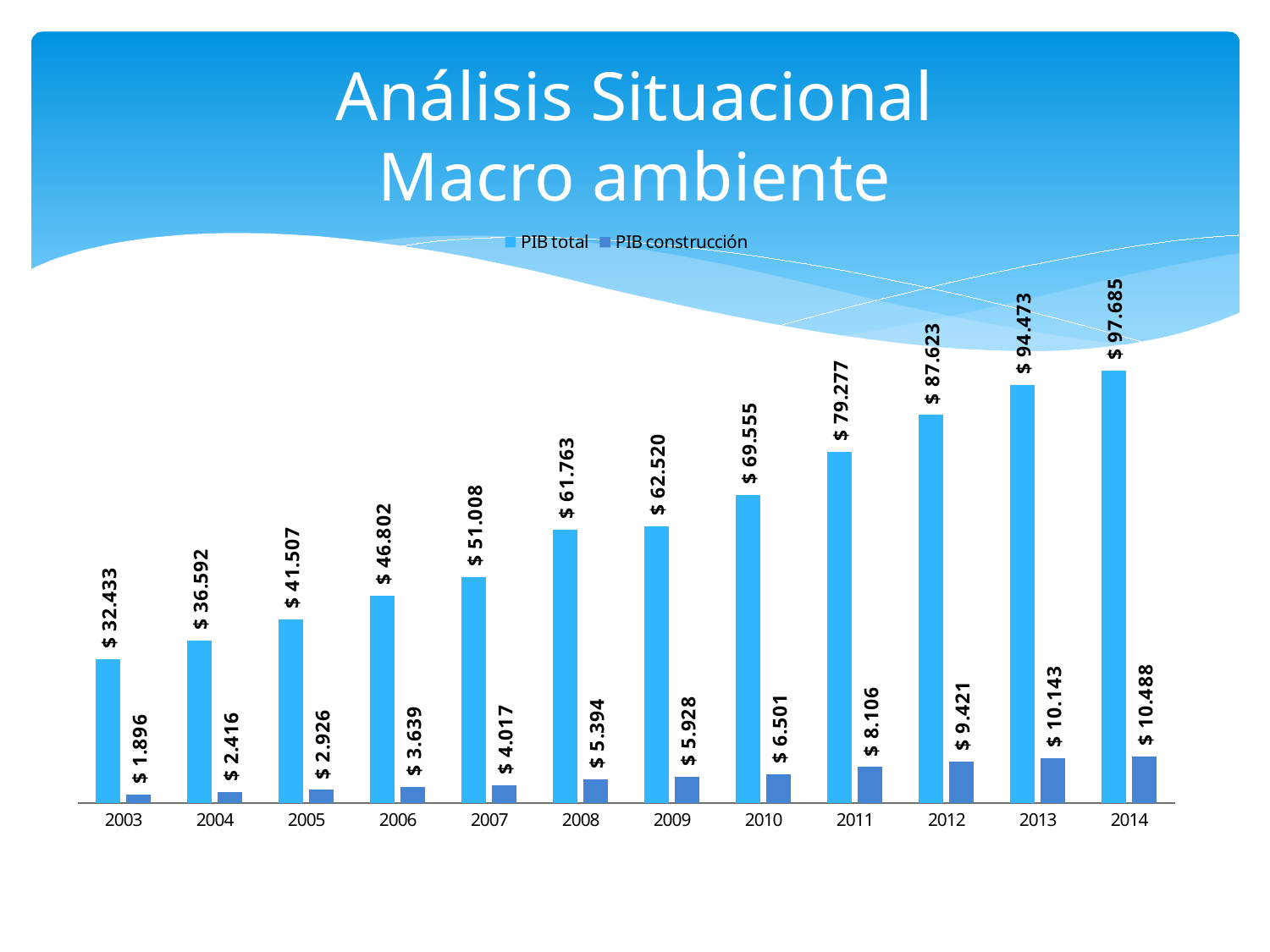
What is the difference between PIB total in 2014 and PIB total in 2013? $ 3.212 What are the two series named in the legend? PIB total and PIB construcción In which year is PIB total the highest? 2014 By how much did PIB construcción grow from 2003 to 2014? $ 8.592 How many series does the legend list? 2 In which year is PIB construcción the lowest? 2003 What is the value of PIB construcción for 2011? $ 8.106 What kind of chart is shown on the slide? Bar chart How many years are shown on the x axis? 12 What is the value of PIB total for 2008? $ 61.763 Which is larger: PIB total in 2010 or PIB total in 2011? PIB total in 2011 Does PIB total rise or fall from 2003 to 2014? Rise